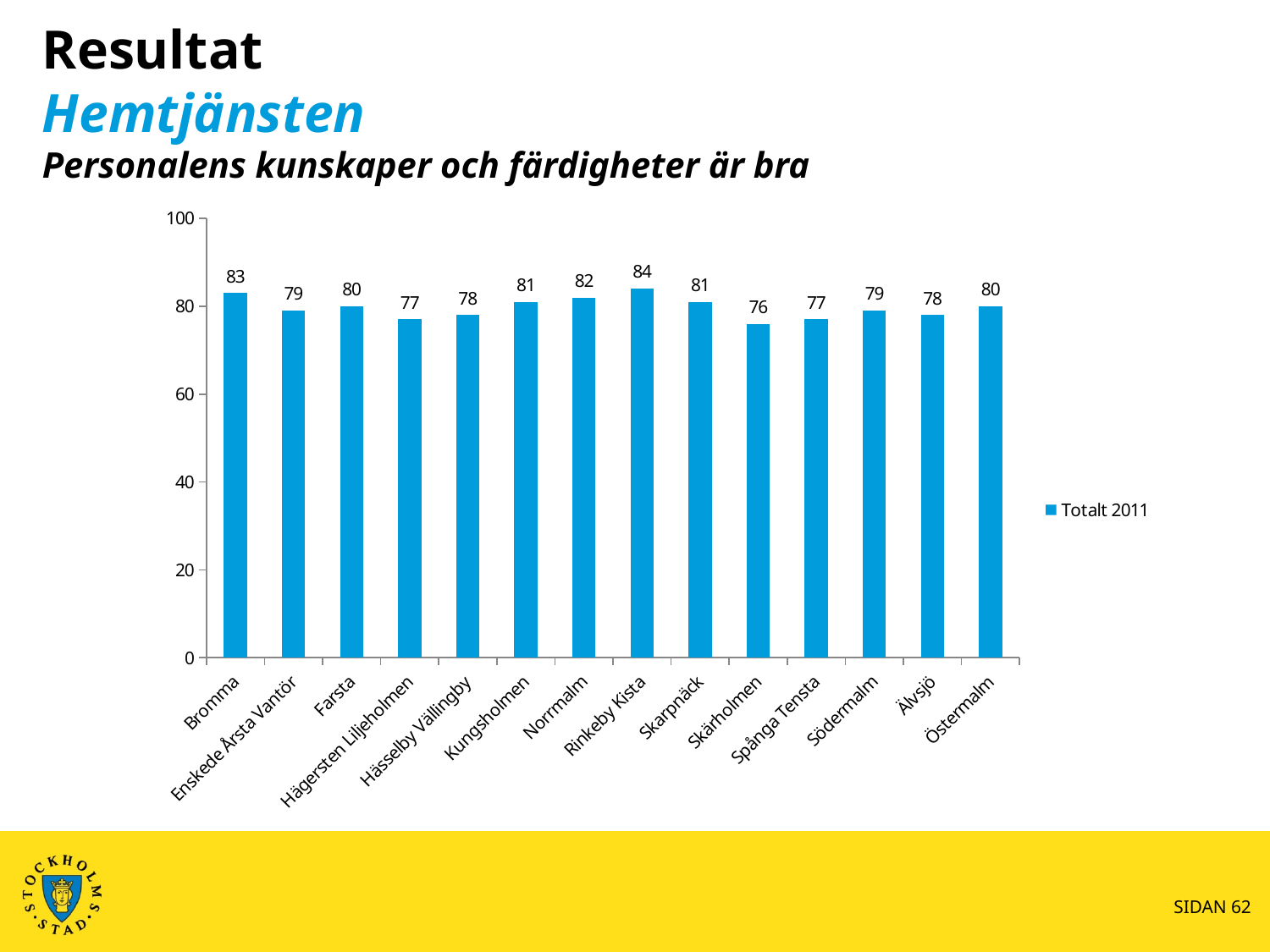
What is the value for Skärholmen? 76 What is the legend entry for the series? Totalt 2011 How many districts are shown on the x axis? 14 What is the value for Bromma? 83 How many series does the legend list? 1 What is the value for Norrmalm? 82 What is the difference between the values for Rinkeby Kista and Skärholmen? 8 What kind of chart is shown? bar chart Which has a larger value, Bromma or Farsta? Bromma Is the value for Kungsholmen greater or less than 60? greater Which district has the highest value? Rinkeby Kista Which district has the lowest value? Skärholmen